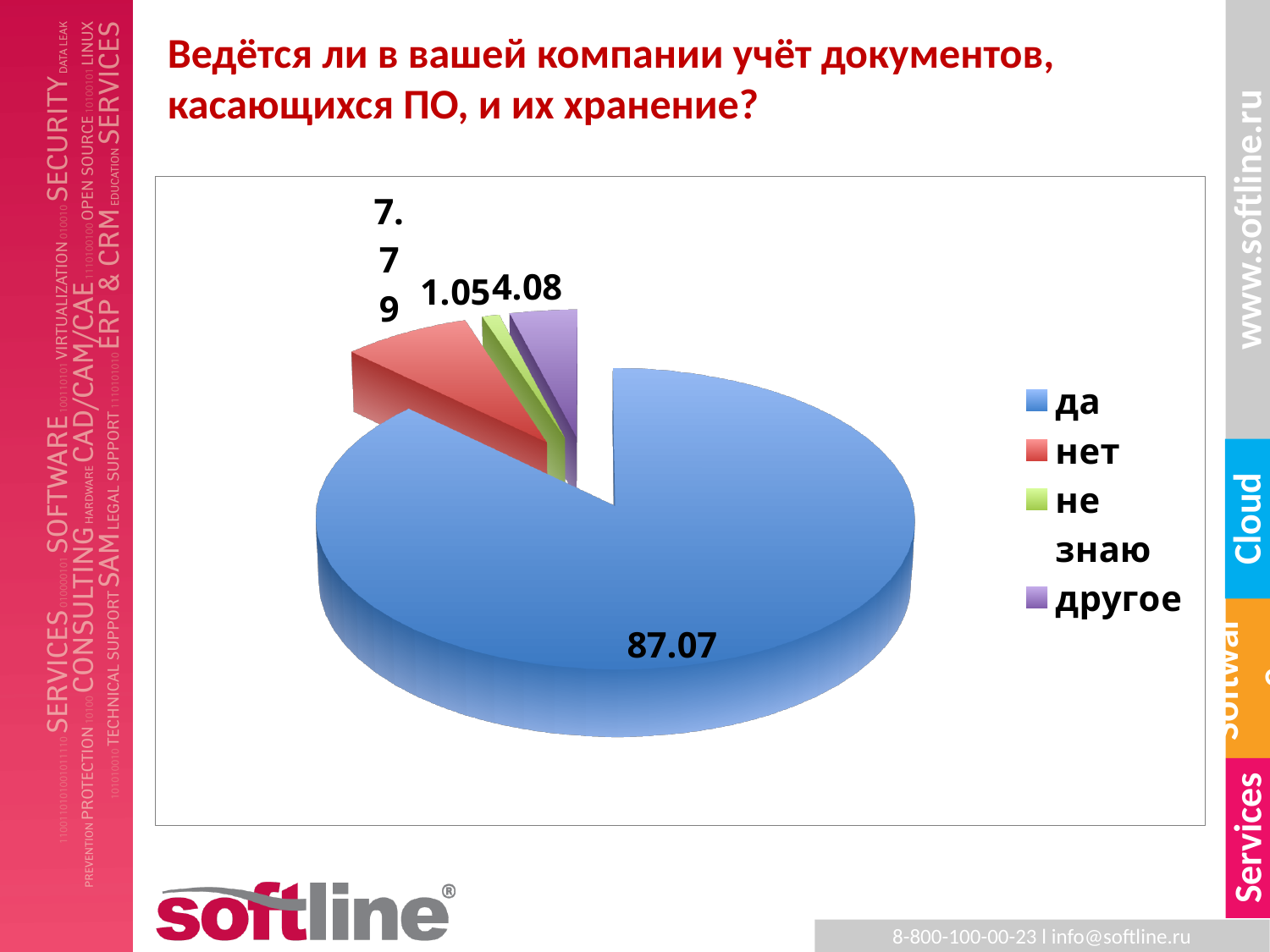
Which category has the largest slice of the pie? да What is the value shown for the "не знаю" slice? 1.05 What colour is the "да" slice of the pie? blue How many categories does the legend list? 4 What is the value shown for the "да" slice? 87.07 What is the value shown for the "нет" slice? 7.79 What type of chart is shown on the slide? pie chart Which is larger, the value for "нет" or the value for "другое"? нет What is the value shown for the "другое" slice? 4.08 What is the difference between the values for "да" and "нет"? 79.28 What is the difference between the values for "другое" and "не знаю"? 3.03 Which category has the smallest slice of the pie? не знаю